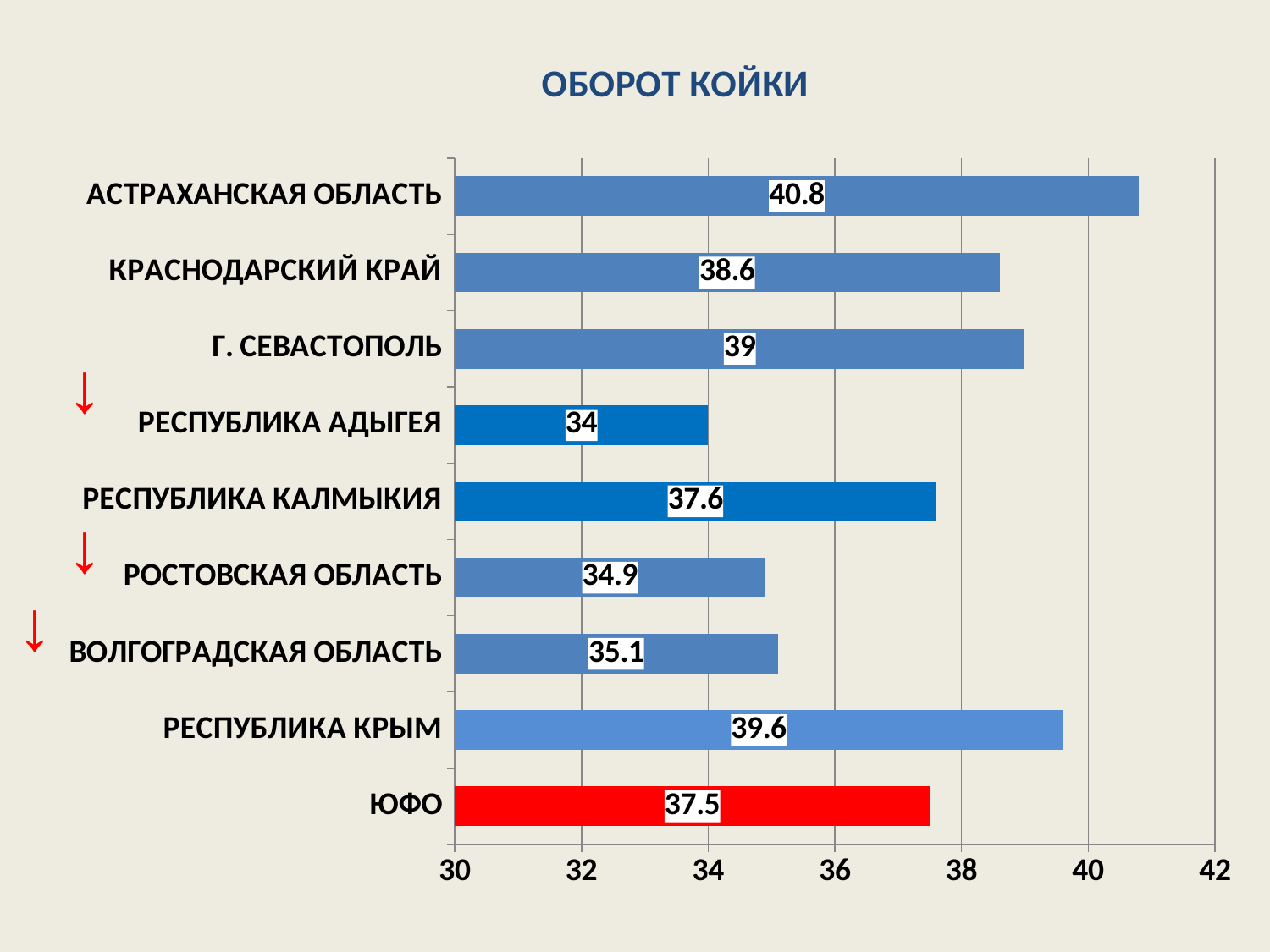
What is the value for Астраханская область? 40.8 Which is larger, the value for Краснодарский край or the value for г. Севастополь? г. Севастополь What is the value for ЮФО? 37.5 What kind of chart is shown on the slide? bar chart What is the difference between the values for Астраханская область and Республика Адыгея? 6.8 What is the title of the chart? ОБОРОТ КОЙКИ Which category has the lowest value? Республика Адыгея What is the value for Республика Калмыкия? 37.6 Is the value for Ростовская область greater or less than 36? less How many categories are shown in the chart? 9 What is the difference between the values for Республика Крым and ЮФО? 2.1 Which category has the highest value? Астраханская область